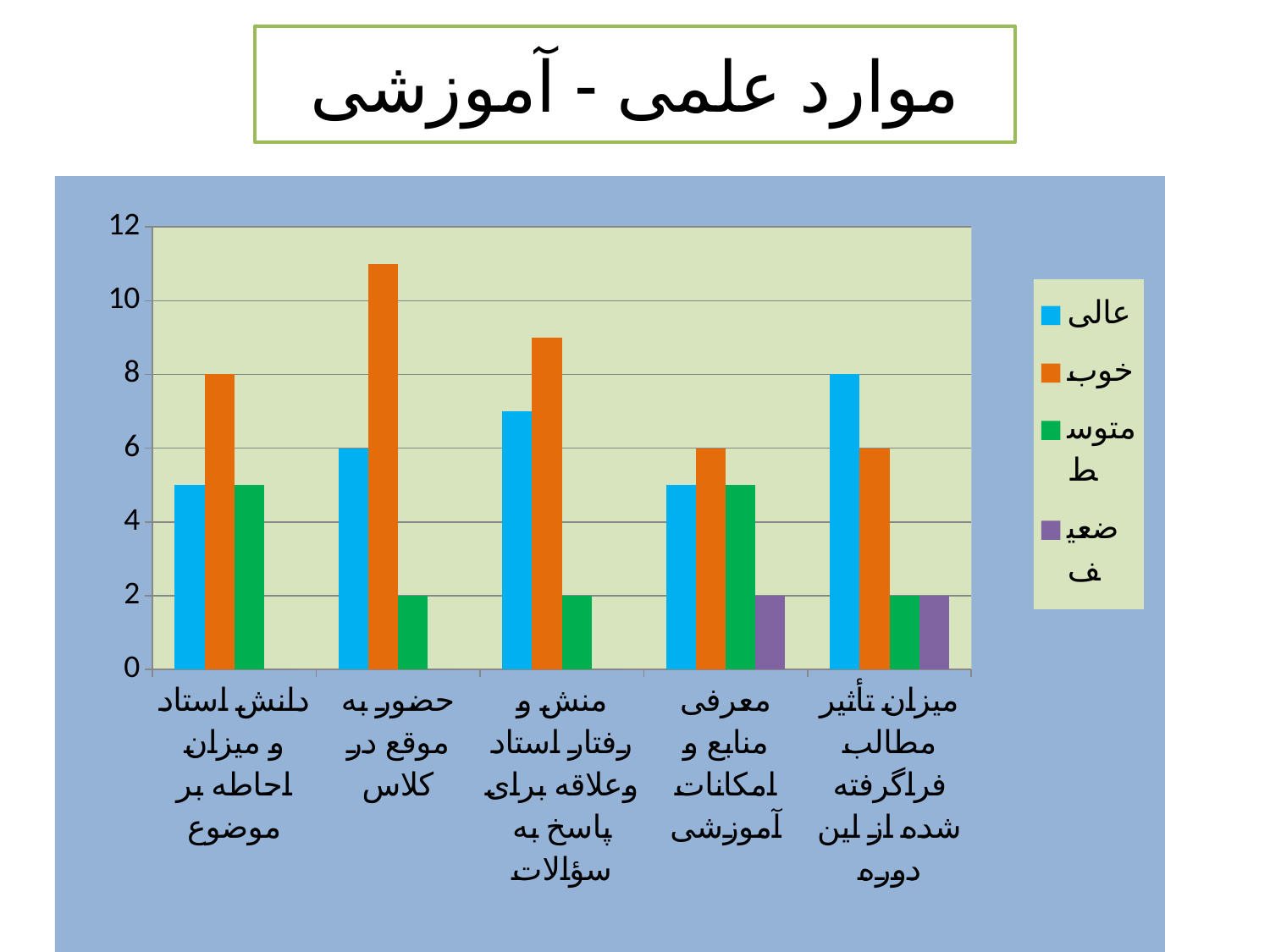
What is the value of خوب for دانش استاد و میزان احاطه بر موضوع? 8 What is the value of ضعیف for معرفی منابع و امکانات آموزشی? 2 What is the value of متوسط for حضور به موقع در کلاس? 2 How many series does the legend list? 4 What kind of chart is shown on the slide? bar chart What is the title of the slide? موارد علمی - آموزشی What is the value of عالی for میزان تأثیر مطالب فراگرفته شده از این دوره? 8 How many categories are shown on the x axis? 5 Which category has the highest خوب value? حضور به موقع در کلاس What is the difference between عالی and خوب for میزان تأثیر مطالب فراگرفته شده از این دوره? 2 For دانش استاد و میزان احاطه بر موضوع, which is larger: عالی or خوب? خوب What is the value of خوب for حضور به موقع در کلاس greater or less than 10? greater